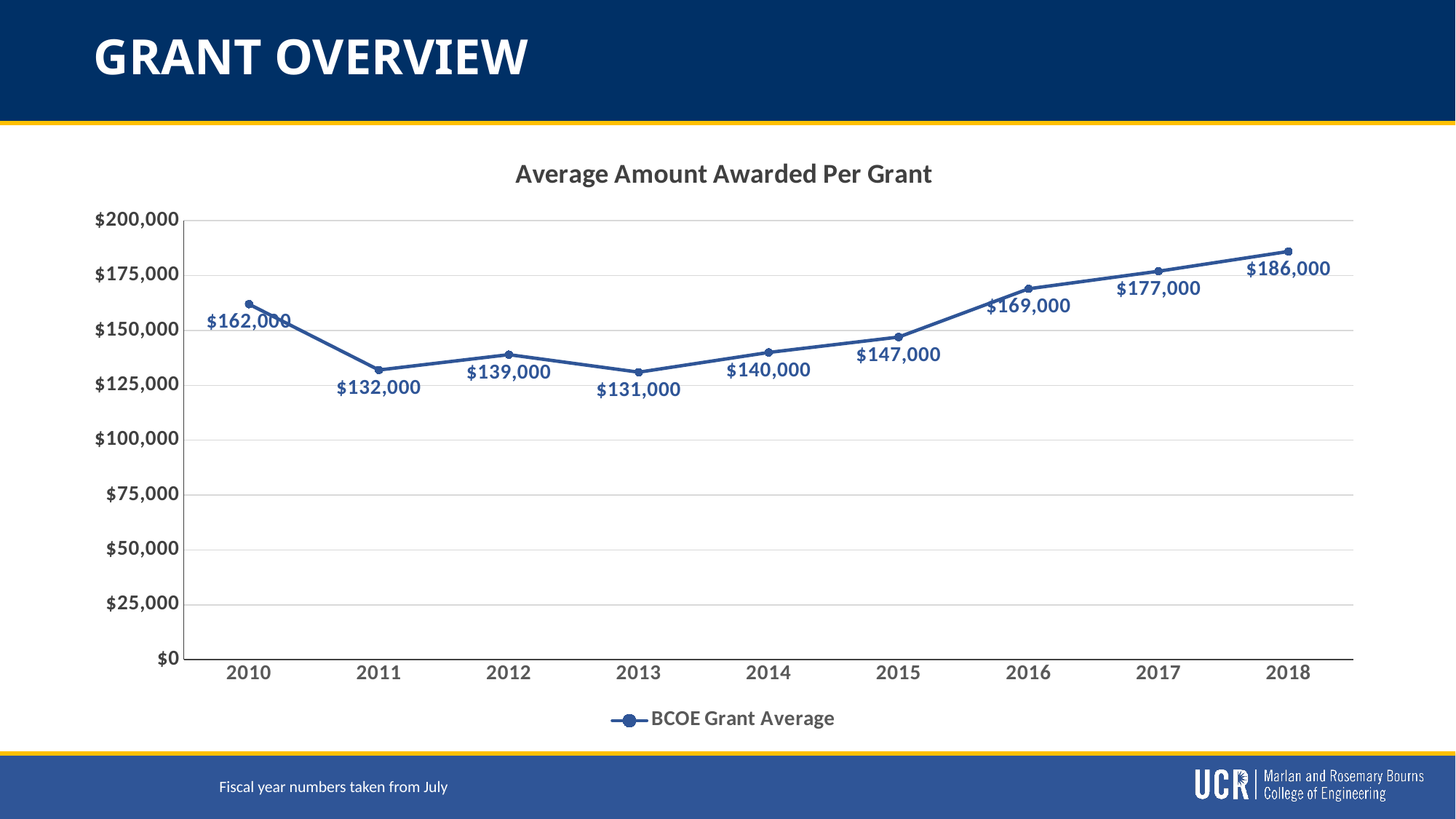
Which year has a larger average grant amount, 2010 or 2016? 2016 Which year has the highest average amount awarded per grant? 2018 How many series does the legend list? 1 What is the average amount awarded per grant in 2013? $131,000 Is the value for 2015 greater or less than $150,000? less What kind of chart is shown on the slide? line chart What is the difference between the average grant amount in 2018 and in 2013? $55,000 What is the average amount awarded per grant in 2018? $186,000 How many years are plotted on the chart? 9 Do the values rise or fall from 2013 to 2018? rise What is the average amount awarded per grant in 2010? $162,000 Which year has the lowest average amount awarded per grant? 2013